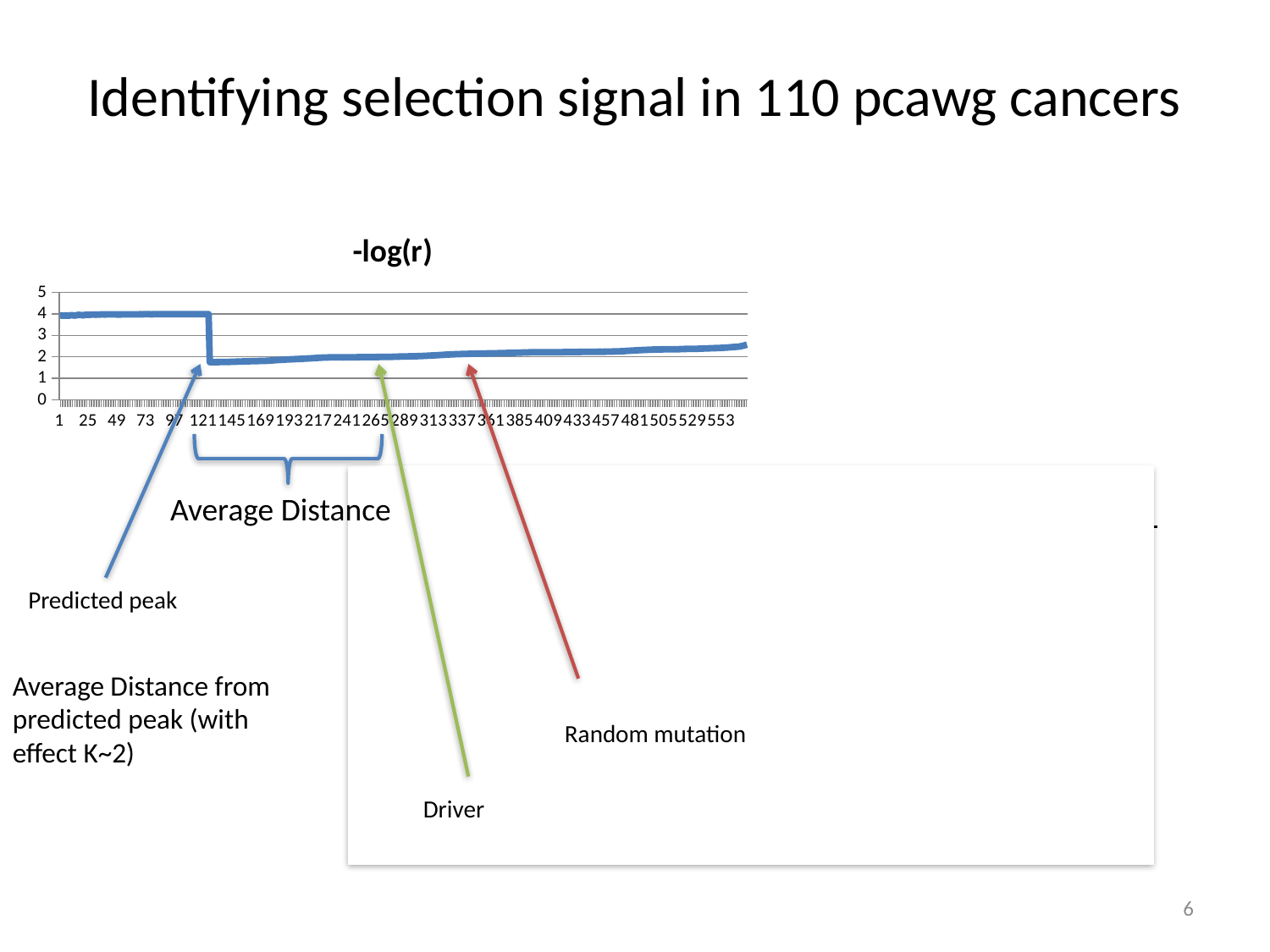
What is the highest value shown on the chart's vertical axis? 5 Is the value of the line at x = 145 greater or less than 3? less What is the title of the chart? -log(r) What is the first tick label on the chart's horizontal axis? 1 Is the value of the line at x = 1 greater or less than 3? greater Is the value of the line at x = 553 greater or less than 1? greater Which is larger, the value of the line at x = 25 or at x = 265? x = 25 After the sharp drop near x = 121, does the line rise or fall as x increases toward 553? rise What kind of chart is shown on the slide? line chart Does the line rise or fall between x = 97 and x = 145? fall